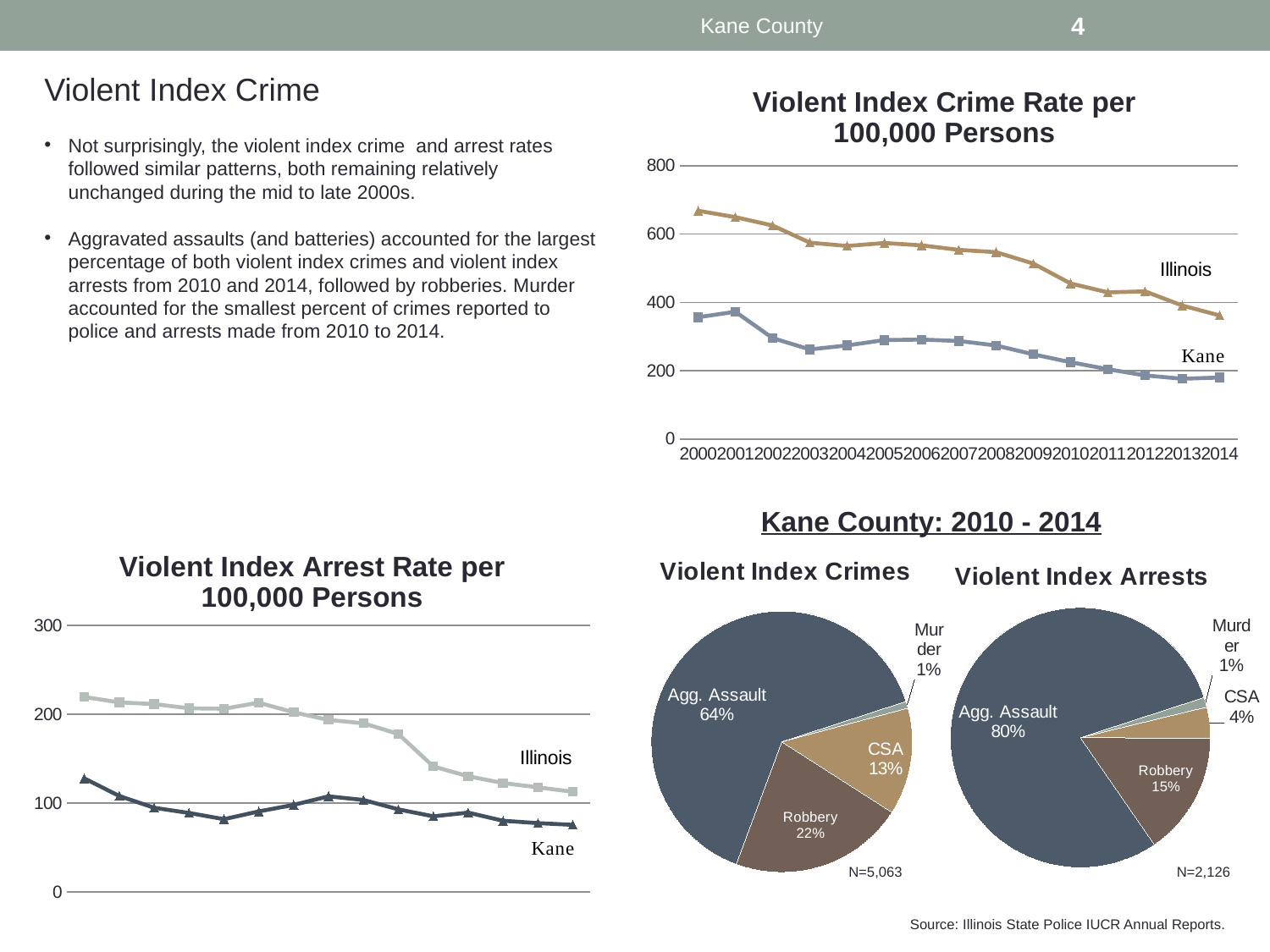
In the Violent Index Crime Rate per 100,000 Persons chart, is the Kane value for 2014 greater or less than 200? less In the Violent Index Arrests pie chart, which category has the smallest slice? Murder In the Violent Index Arrests pie chart, what share of arrests is Agg. Assault? 80% In the Violent Index Crime Rate per 100,000 Persons chart, is the Illinois value for 2000 greater or less than 600? greater In the Violent Index Crime Rate per 100,000 Persons chart, does the Illinois line rise or fall from 2000 to 2014? Fall How many percentage points higher is the Agg. Assault share in the Violent Index Arrests pie chart than in the Violent Index Crimes pie chart? 16 percentage points In the Violent Index Crimes pie chart, what share of crimes is Robbery? 22% In the Violent Index Crimes pie chart, which category has the largest slice? Agg. Assault Is the CSA share larger in the Violent Index Crimes pie chart or the Violent Index Arrests pie chart? Violent Index Crimes How many series are plotted in the Violent Index Crime Rate per 100,000 Persons chart? 2 How many slices does the Violent Index Crimes pie chart have? 4 What kind of chart is the Violent Index Crime Rate per 100,000 Persons chart? Line chart